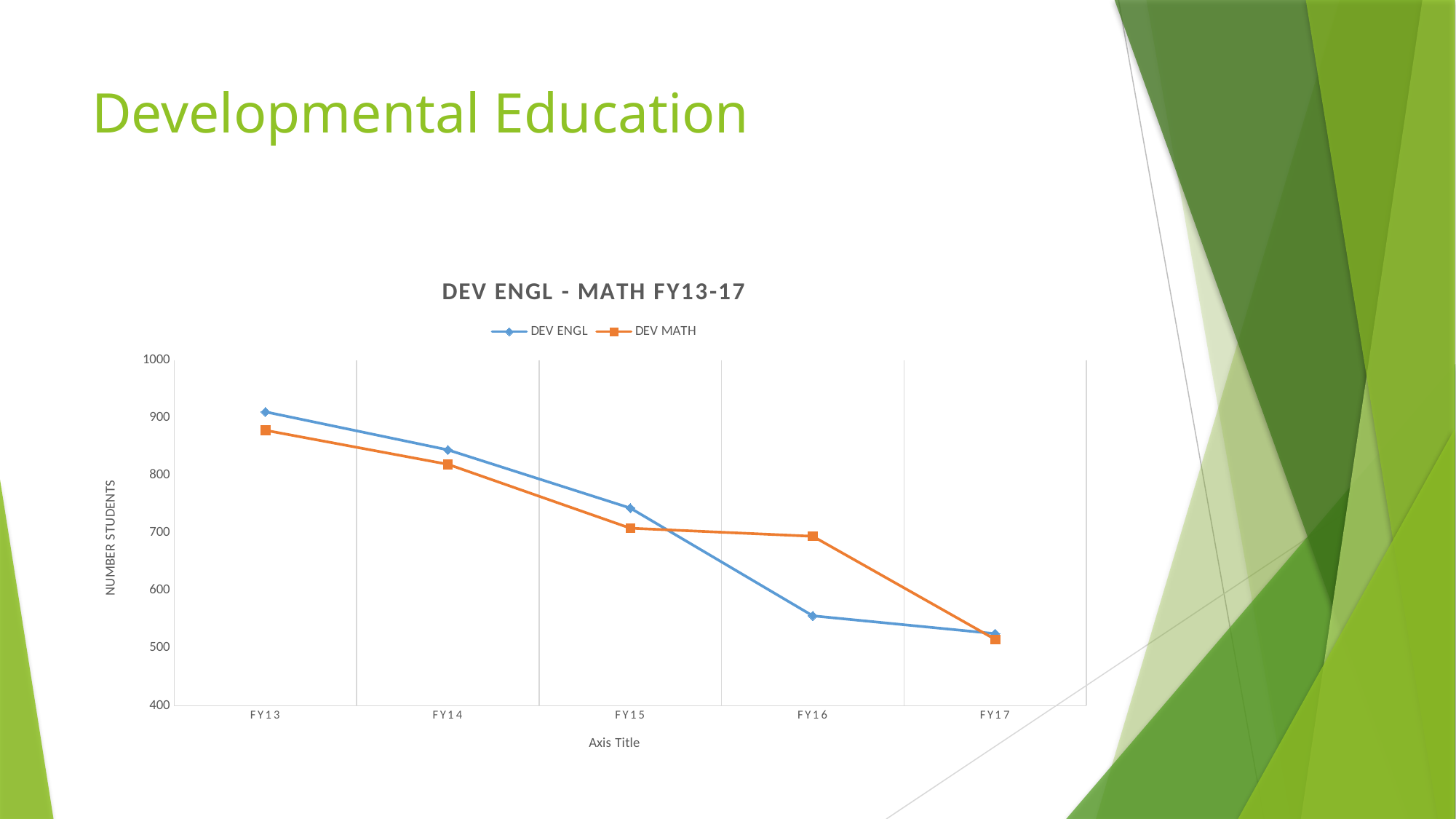
How many fiscal years are plotted along the x axis? 5 What is the label on the vertical axis? NUMBER STUDENTS What is the title of the chart? DEV ENGL - MATH FY13-17 How many series does the legend list? 2 In which fiscal year is the DEV MATH value lowest? FY17 What kind of chart is shown on the slide? line chart Do the DEV ENGL values rise or fall from FY13 to FY17? fall In FY16, which series has the larger value, DEV ENGL or DEV MATH? DEV MATH Is the DEV ENGL value for FY13 greater or less than 900? greater In which fiscal year is the DEV ENGL value highest? FY13 Is the DEV ENGL value for FY16 greater or less than 600? less